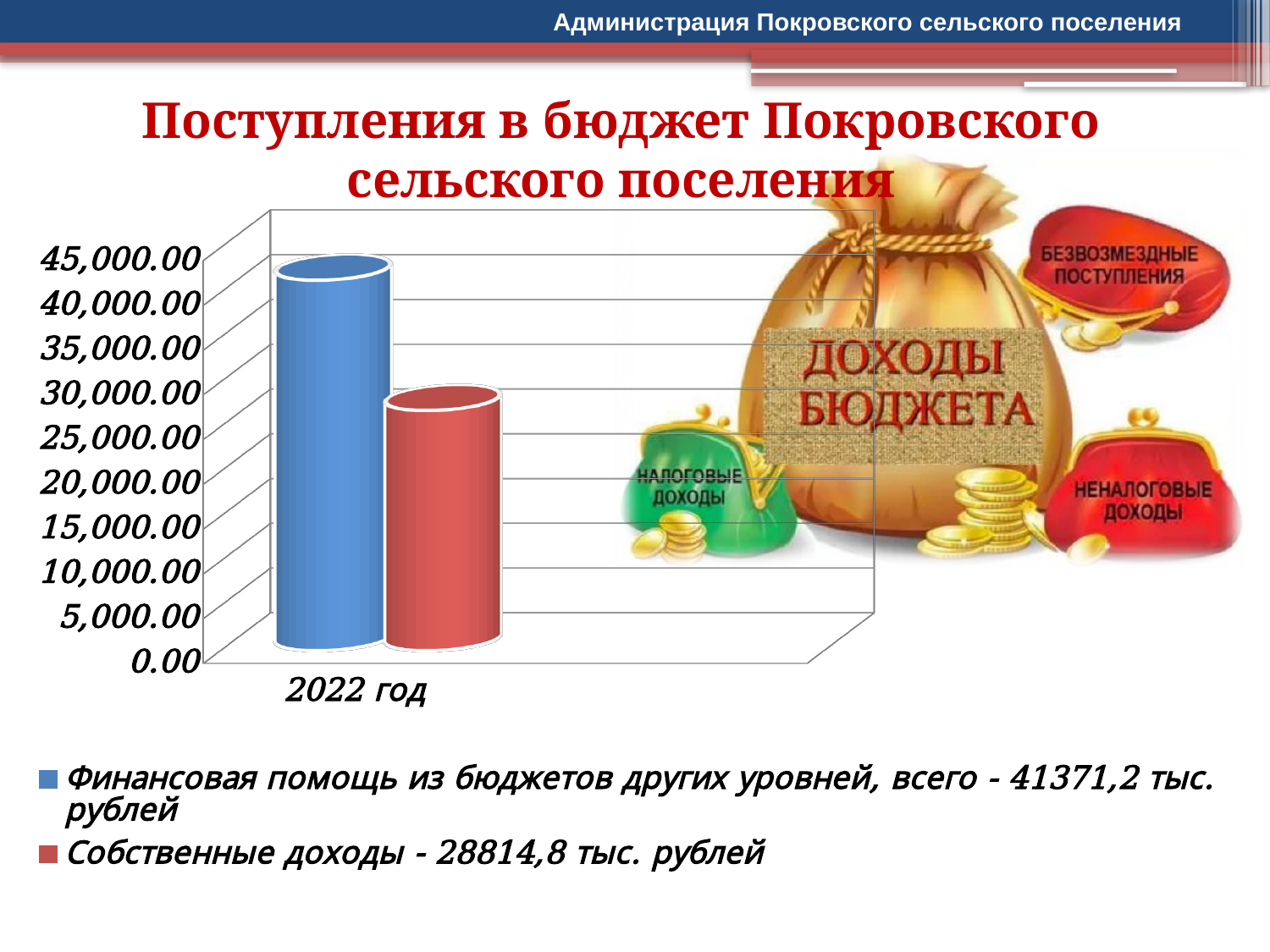
What is the difference between 'Финансовая помощь из бюджетов других уровней' and 'Собственные доходы' in 2022? 12556,4 тыс. рублей Which series has the higher value in 2022: 'Финансовая помощь из бюджетов других уровней' or 'Собственные доходы'? Финансовая помощь из бюджетов других уровней Is the value for 'Финансовая помощь из бюджетов других уровней' greater or less than 40,000.00? greater How many series does the chart legend list? 2 What is the category label on the x axis of the chart? 2022 год How many categories are shown on the x axis of the chart? 1 What is the value for 'Собственные доходы' in 2022? 28814,8 тыс. рублей What is the value for 'Финансовая помощь из бюджетов других уровней, всего' in 2022? 41371,2 тыс. рублей What colour is the bar for 'Собственные доходы'? red Is the value for 'Собственные доходы' greater or less than 30,000.00? less Which series has the lowest value in the chart? Собственные доходы What kind of chart is shown on the slide? bar chart